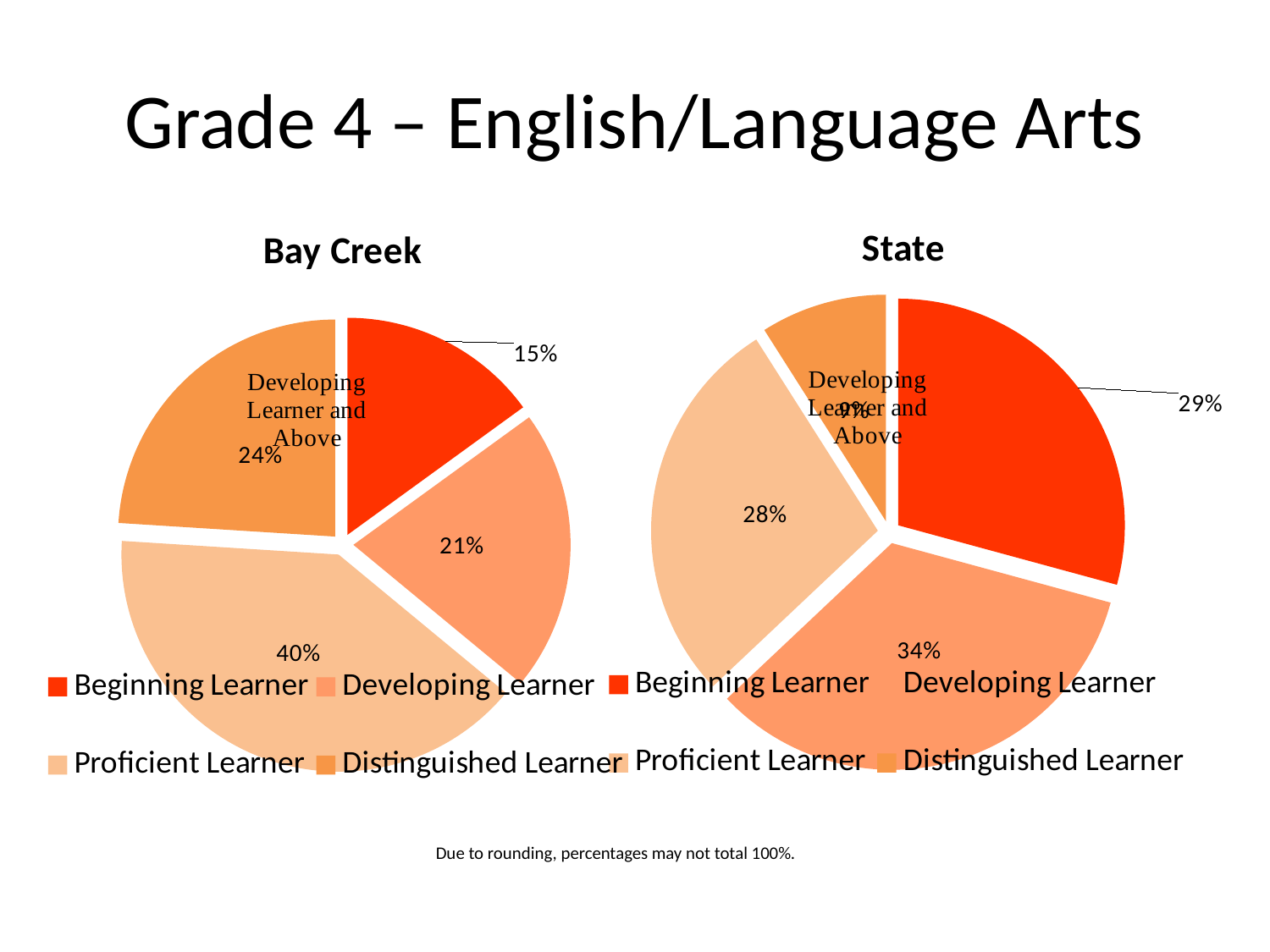
In the Bay Creek chart, which category has the smallest slice? Beginning Learner In the Bay Creek chart, how many percentage points larger is the Proficient Learner slice than the Developing Learner slice? 19 percentage points In the State chart, which category has the largest slice? Developing Learner In the Bay Creek chart, what percentage of students are Proficient Learners? 40% In the Bay Creek chart, which category has the largest slice? Proficient Learner In the State chart, what percentage of students are Beginning Learners? 29% In the Bay Creek chart, what percentage of students are Distinguished Learners? 24% In the State chart, what percentage of students are Developing Learners? 34% What type of chart is used for the Bay Creek and State data? Pie chart Which chart shows a larger share of Beginning Learners, Bay Creek or State? State How many categories does the legend of the Bay Creek chart list? 4 In the Bay Creek chart, what percentage of students are Beginning Learners? 15%